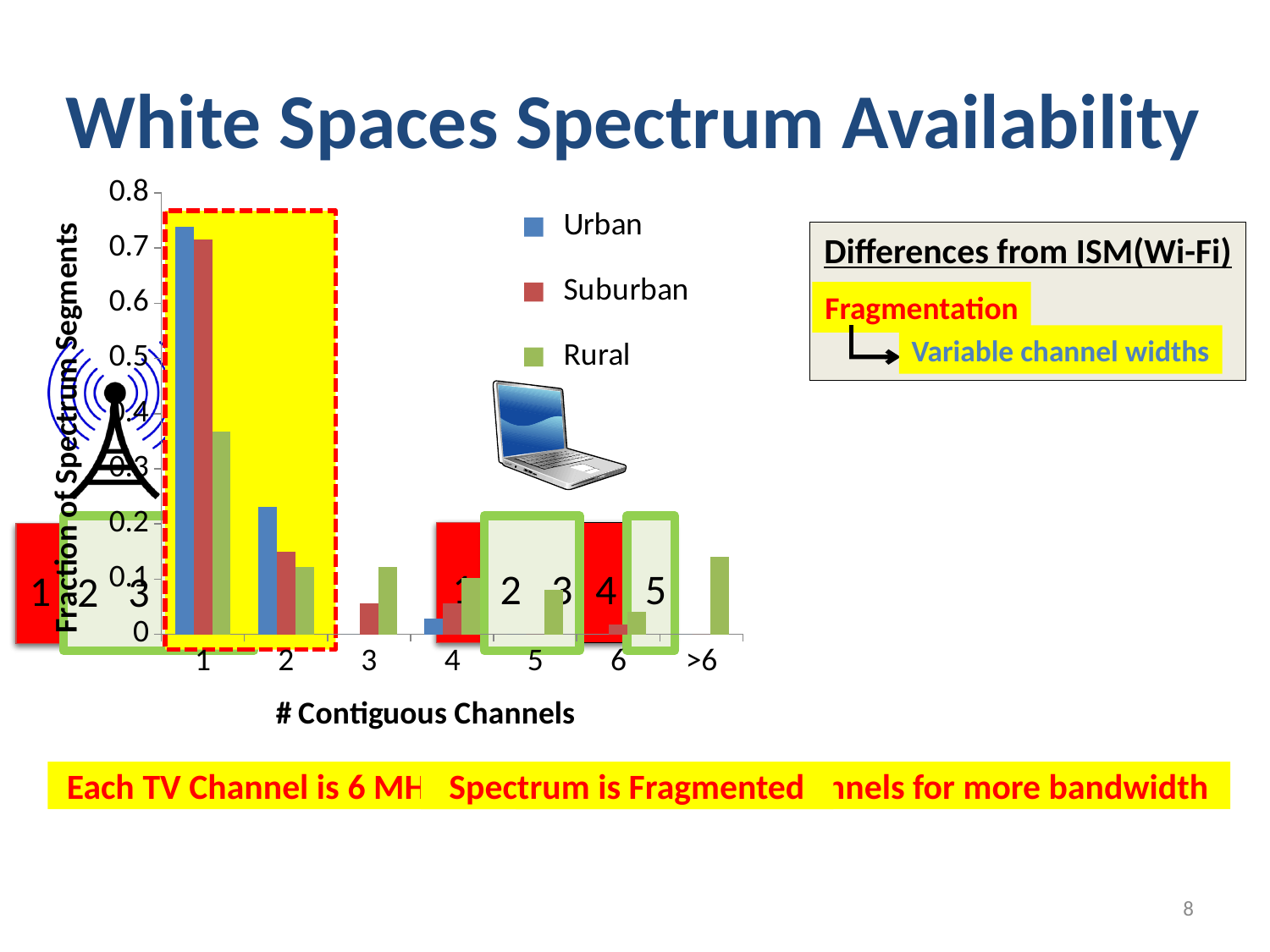
What kind of chart is shown on the slide? bar chart For which number of contiguous channels is the Urban value highest? 1 For 1 contiguous channel, which is larger: the Urban value or the Rural value? Urban What is the title of the chart's y axis? Fraction of Spectrum Segments Is the Urban value for 2 contiguous channels greater or less than 0.3? less Do the Urban values rise or fall as the number of contiguous channels increases from 1 to 4? fall How many series does the chart's legend list? 3 What is the title of the chart's x axis? # Contiguous Channels How many categories are shown on the x axis of the chart? 7 For 3 contiguous channels, which is larger: the Rural value or the Suburban value? Rural Is the Urban value for 1 contiguous channel greater or less than 0.5? greater Is the Rural value for 1 contiguous channel greater or less than 0.5? less